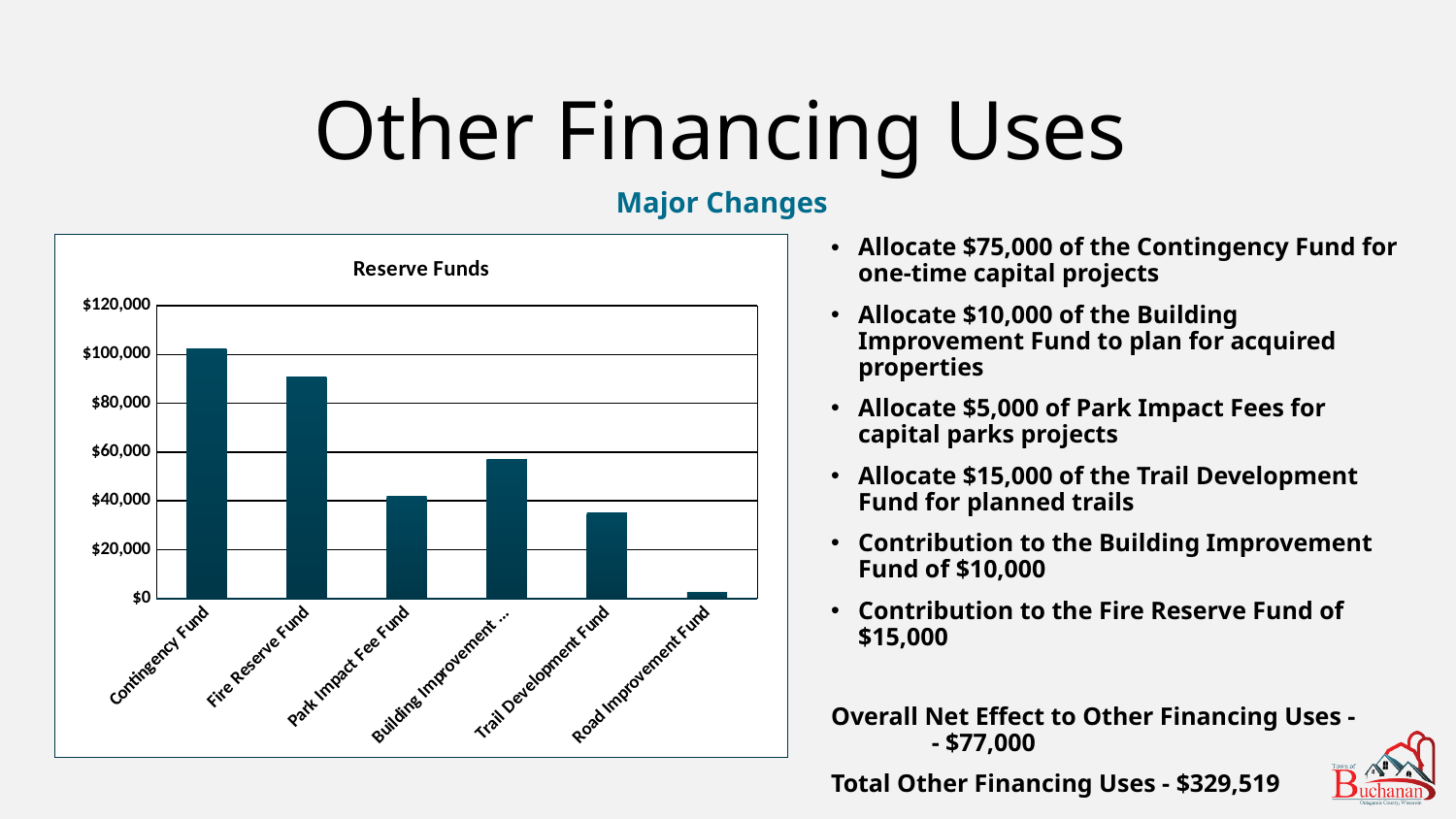
Is the value for Fire Reserve Fund greater or less than $80,000? greater How many categories are plotted in the Reserve Funds chart? 6 Which category has the highest value in the Reserve Funds chart? Contingency Fund Is the value for Trail Development Fund greater or less than $40,000? less What is the title of the chart? Reserve Funds Which is larger, the value for Fire Reserve Fund or the value for Park Impact Fee Fund? Fire Reserve Fund What kind of chart is shown on the slide? Bar chart Is the value for Road Improvement Fund greater or less than $20,000? less Which is larger, the value for Building Improvement or the value for Trail Development Fund? Building Improvement Which category has the lowest value in the Reserve Funds chart? Road Improvement Fund